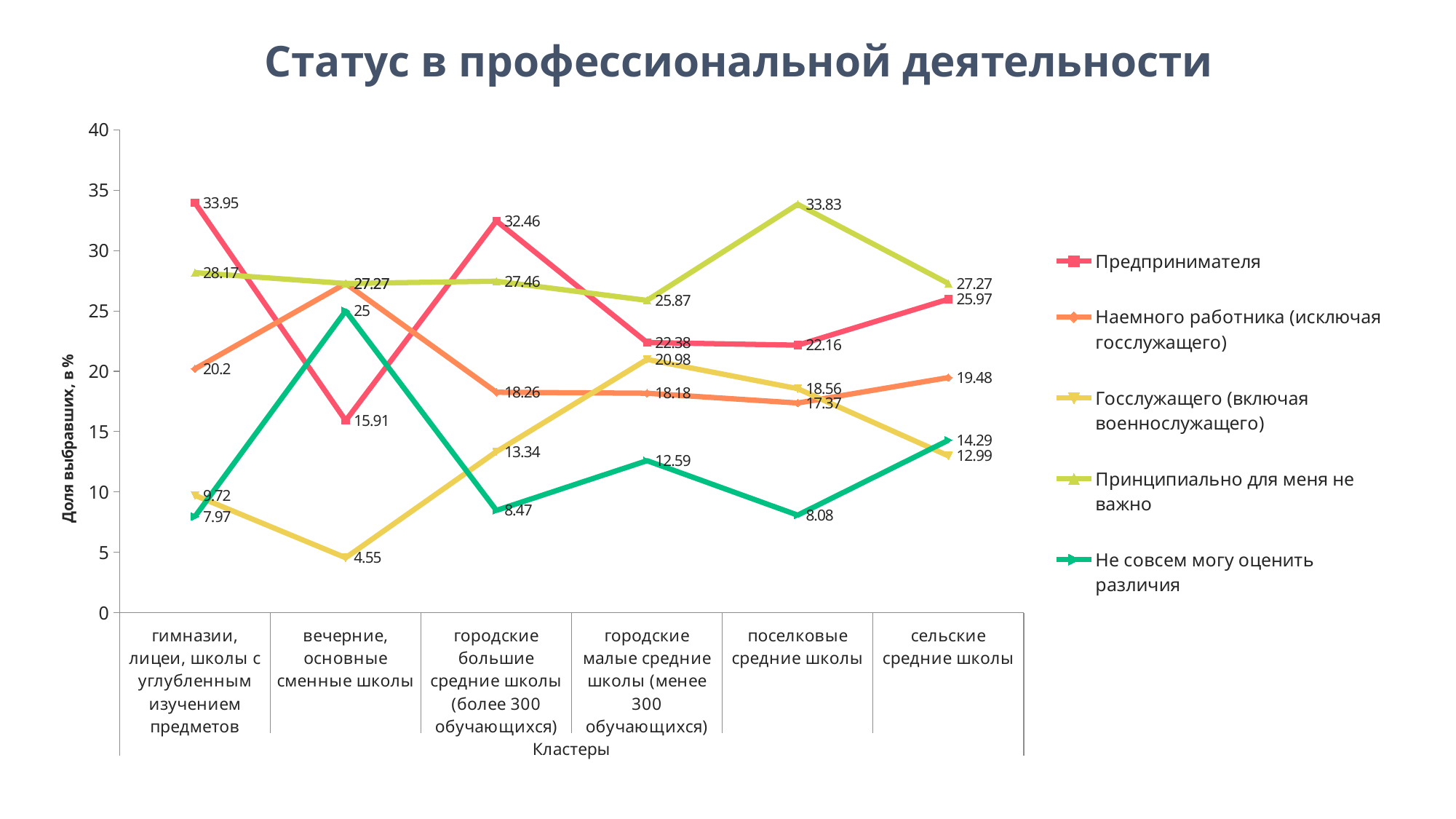
What is the title of the chart? Статус в профессиональной деятельности Is the value for «Не совсем могу оценить различия» in the cluster «вечерние, основные сменные школы» greater or less than 20? greater What is the value for «Не совсем могу оценить различия» in the cluster «сельские средние школы»? 14.29 In which cluster does the series «Предпринимателя» have its lowest value? вечерние, основные сменные школы What is the value for «Предпринимателя» in the cluster «гимназии, лицеи, школы с углубленным изучением предметов»? 33.95 In the cluster «городские малые средние школы (менее 300 обучающихся)», which is larger: «Госслужащего (включая военнослужащего)» or «Наемного работника (исключая госслужащего)»? Госслужащего (включая военнослужащего) How many series does the legend list? 5 In which cluster does the series «Принципиально для меня не важно» reach its highest value? поселковые средние школы How many clusters (categories) are shown on the x axis? 6 What is the difference between «Предпринимателя» and «Наемного работника (исключая госслужащего)» in the cluster «городские большие средние школы (более 300 обучающихся)»? 14.2 What type of chart is shown on the slide? line chart What is the value for «Госслужащего (включая военнослужащего)» in the cluster «вечерние, основные сменные школы»? 4.55